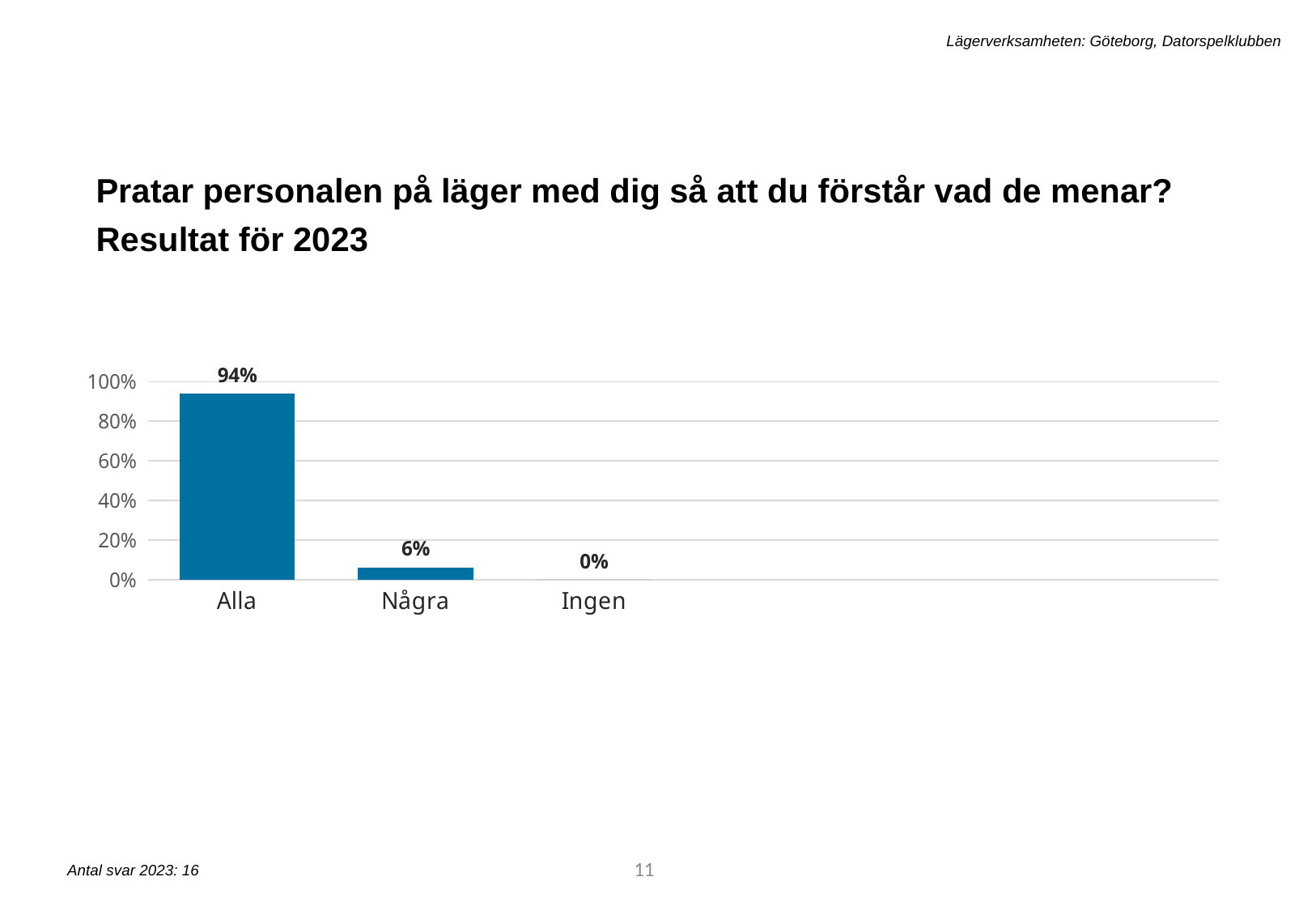
What kind of chart is shown on the slide? bar chart Is the value for Alla greater or less than 80%? greater Which category has the lowest value? Ingen What is the value for Några? 6% Do the values rise or fall from left to right along the x axis? fall What is the value for Alla? 94% What is the number of responses (Antal svar) for 2023 stated on the slide? 16 Which is larger, the value for Några or the value for Ingen? Några Which category has the highest value? Alla What is the value for Ingen? 0% What is the difference between the values for Alla and Några? 88% How many categories are shown on the x axis? 3